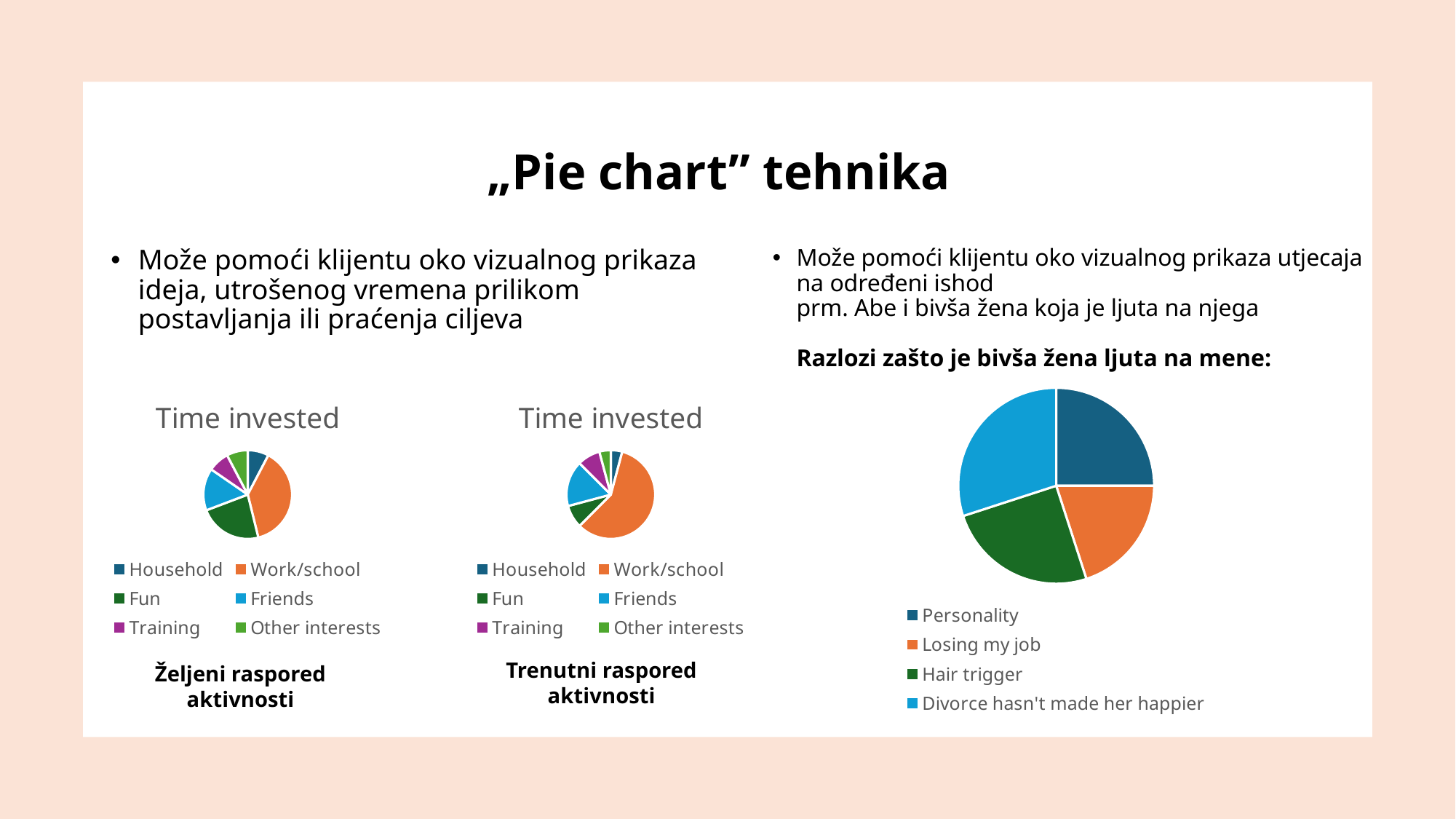
In the middle "Time invested" pie chart (Trenutni raspored aktivnosti), which slice is larger: Friends or Fun? Friends In the left "Time invested" pie chart (Željeni raspored aktivnosti), which slice is larger: Fun or Training? Fun In the pie chart titled "Razlozi zašto je bivša žena ljuta na mene", which slice is larger: Divorce hasn't made her happier or Losing my job? Divorce hasn't made her happier What kind of chart is the middle chart titled "Time invested" (Trenutni raspored aktivnosti)? Pie chart In the left "Time invested" pie chart (Željeni raspored aktivnosti), which category has the largest slice? Work/school In the middle "Time invested" pie chart (Trenutni raspored aktivnosti), which category has the largest slice? Work/school How many pie charts are shown on the slide? 3 What kind of chart is the chart titled "Razlozi zašto je bivša žena ljuta na mene"? Pie chart How many categories does the legend of the left "Time invested" pie chart (Željeni raspored aktivnosti) list? 6 How many slices does the pie chart titled "Razlozi zašto je bivša žena ljuta na mene" have? 4 In the pie chart titled "Razlozi zašto je bivša žena ljuta na mene", which category is shown in orange? Losing my job In the pie chart titled "Razlozi zašto je bivša žena ljuta na mene", which category has the largest slice? Divorce hasn't made her happier